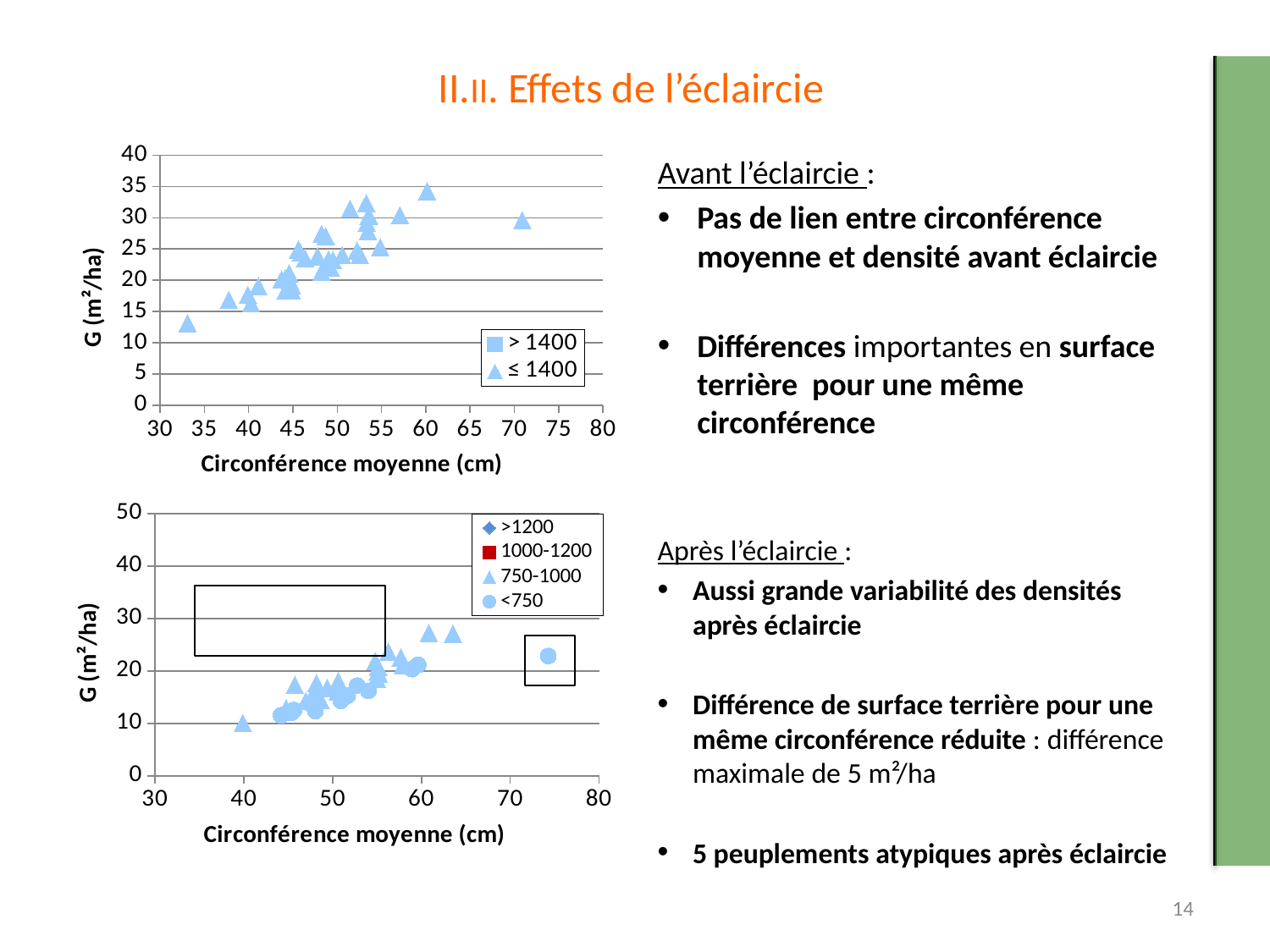
In the bottom chart, is the G value of the isolated circle point at about 74 cm circumference greater or less than 20? greater In the bottom chart, is the G value of the isolated circle point at about 74 cm circumference greater or less than 30? less In the bottom chart, what is the label of the y axis? G (m²/ha) In the top chart, do the G values generally rise or fall as the mean circumference increases? rise In the top chart, is the G value of the isolated point at about 71 cm circumference greater or less than 25? greater What kind of chart is the bottom chart on the slide? scatter chart In the top chart, what is the label of the x axis? Circonférence moyenne (cm) How many series does the legend of the top chart list? 2 What kind of chart is the top chart on the slide? scatter chart How many series does the legend of the bottom chart list? 4 In the bottom chart, do the G values generally rise or fall as the mean circumference increases? rise